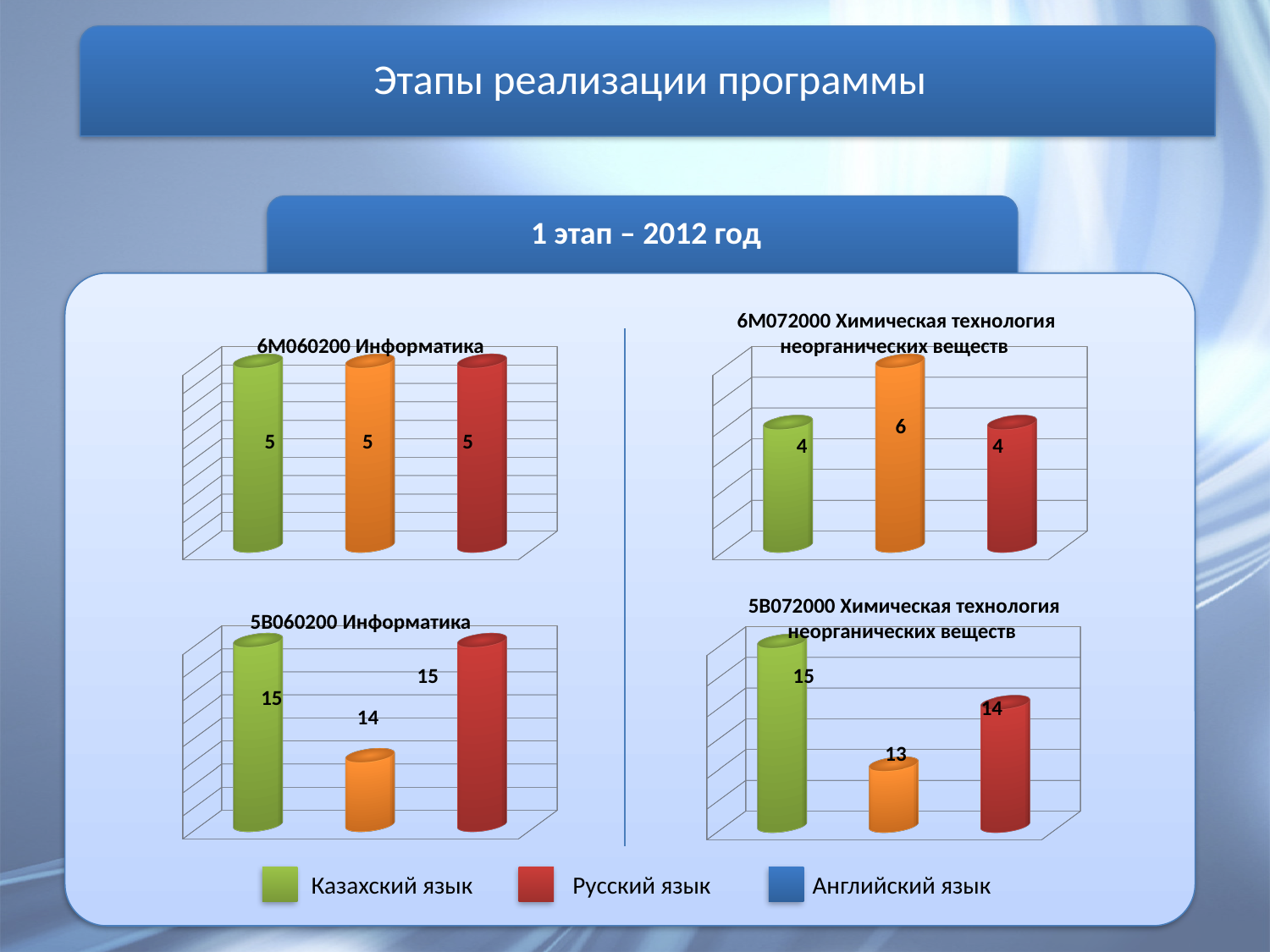
In the chart titled 6M072000 Химическая технология неорганических веществ, which bar colour has the highest value? orange In the chart titled 5B072000 Химическая технология неорганических веществ, what is the value of the red bar? 14 In the chart titled 5B060200 Информатика, what is the value of the orange bar? 14 In the chart titled 5B072000 Химическая технология неорганических веществ, which bar colour has the lowest value? orange In the chart titled 5B060200 Информатика, is the green bar or the orange bar larger? green In the chart titled 6M060200 Информатика, what is the value of the green bar? 5 How many bars are shown in the chart titled 6M060200 Информатика? 3 In the chart titled 6M072000 Химическая технология неорганических веществ, what is the value of the orange bar? 6 In the chart titled 6M072000 Химическая технология неорганических веществ, what is the difference between the orange bar and the green bar? 2 In the chart titled 5B072000 Химическая технология неорганических веществ, what is the difference between the green bar and the orange bar? 2 What type of chart is used for 5B060200 Информатика? bar chart According to the legend at the bottom of the slide, which language does the green colour represent? Казахский язык